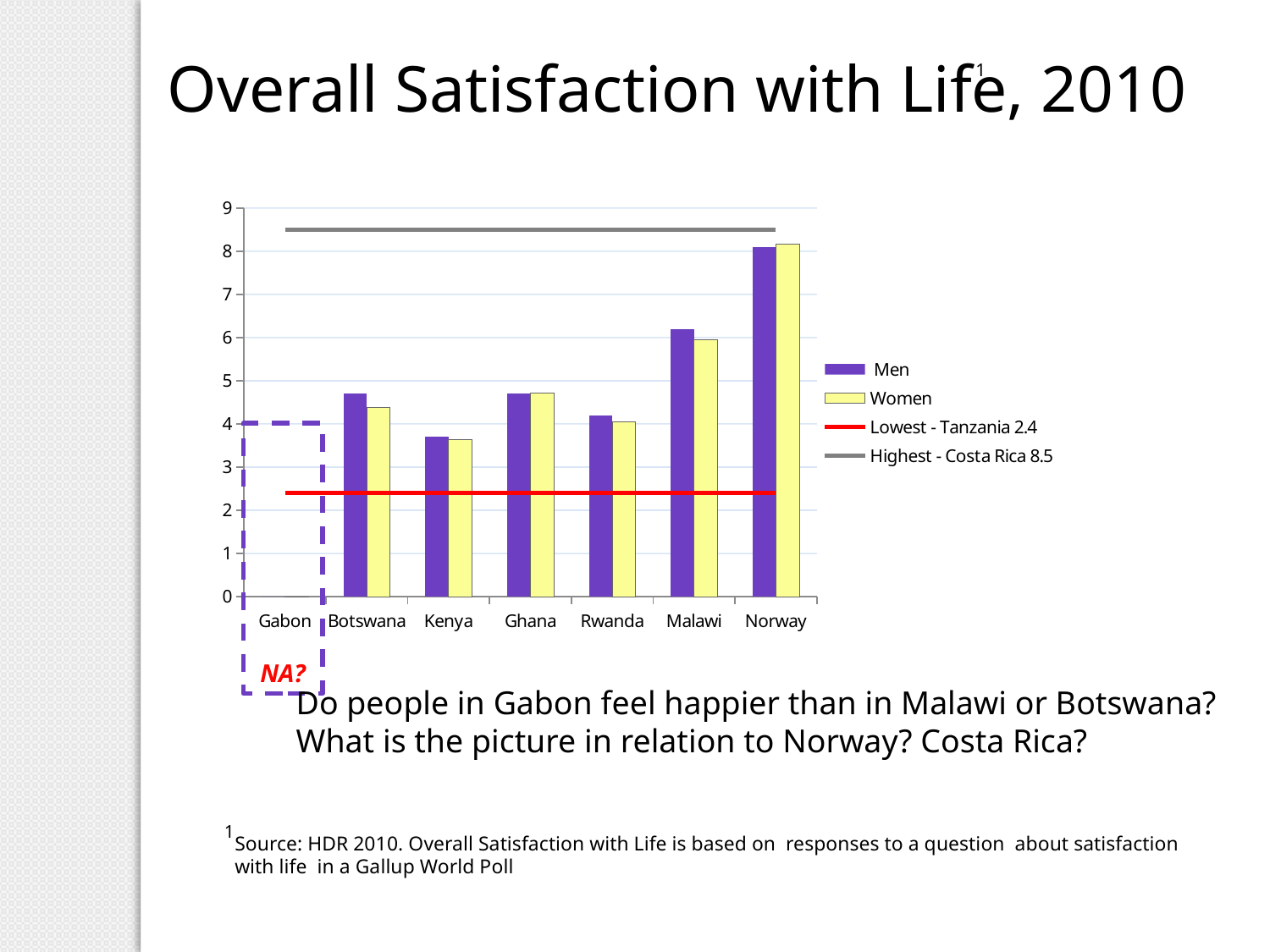
Is the Men value for Malawi greater or less than 6? greater According to the legend, what is the value of the highest country, Costa Rica? 8.5 Which country on the x axis has no bars plotted and is marked 'NA?'? Gabon How many entries does the chart legend list? 4 How many countries are labelled along the x axis of the chart? 7 Among the countries with bars plotted, which has the lowest Women bar? Kenya Which country has the highest Men bar in the chart? Norway According to the legend, what is the value of the lowest country, Tanzania? 2.4 What kind of chart is shown on the slide? bar chart Which is larger, the Men value for Malawi or the Men value for Botswana? Malawi Is the Women value for Botswana greater or less than 5? less